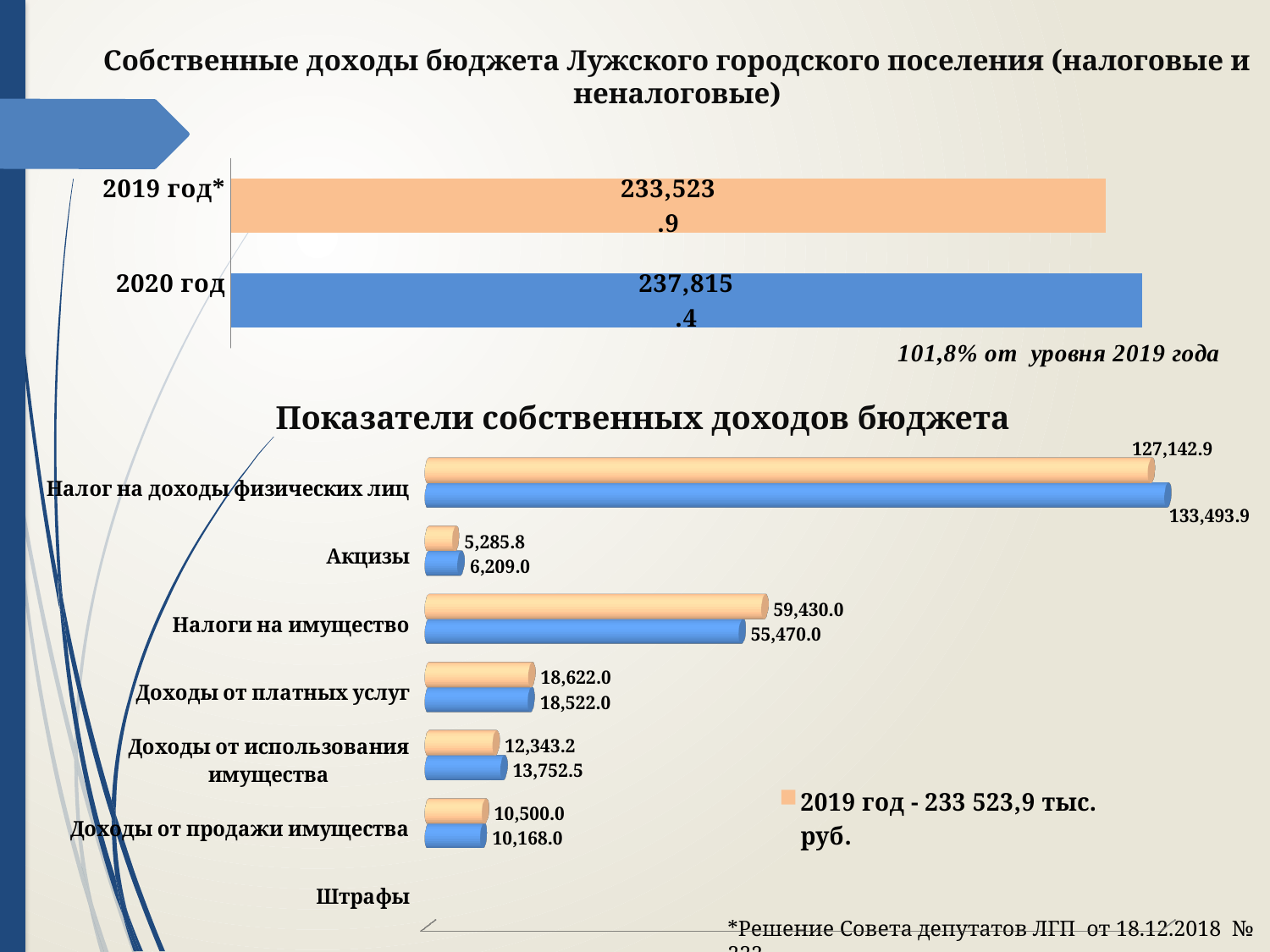
In the top chart, what is the value for 2019 год*? 233,523.9 In the chart 'Показатели собственных доходов бюджета', what is the value of the blue bar for Доходы от использования имущества? 13,752.5 In the top chart, what is the difference between the 2020 год and 2019 год* values? 4,291.5 What type of chart is 'Показатели собственных доходов бюджета'? Bar chart In the chart 'Показатели собственных доходов бюджета', what is the difference between the orange and blue bars for Налоги на имущество? 3,960.0 In the chart 'Показатели собственных доходов бюджета', what is the value of the orange bar for Налоги на имущество? 59,430.0 In the top chart, what is the value for 2020 год? 237,815.4 In the chart 'Показатели собственных доходов бюджета', which category has the highest values? Налог на доходы физических лиц In the chart 'Показатели собственных доходов бюджета', what is the difference between the blue and orange bars for Налог на доходы физических лиц? 6,351.0 In the top chart, which year has the larger value, 2019 год* or 2020 год? 2020 год In the chart 'Показатели собственных доходов бюджета', how many categories are listed on the vertical axis? 7 In the chart 'Показатели собственных доходов бюджета', what is the value of the blue bar for Налог на доходы физических лиц? 133,493.9